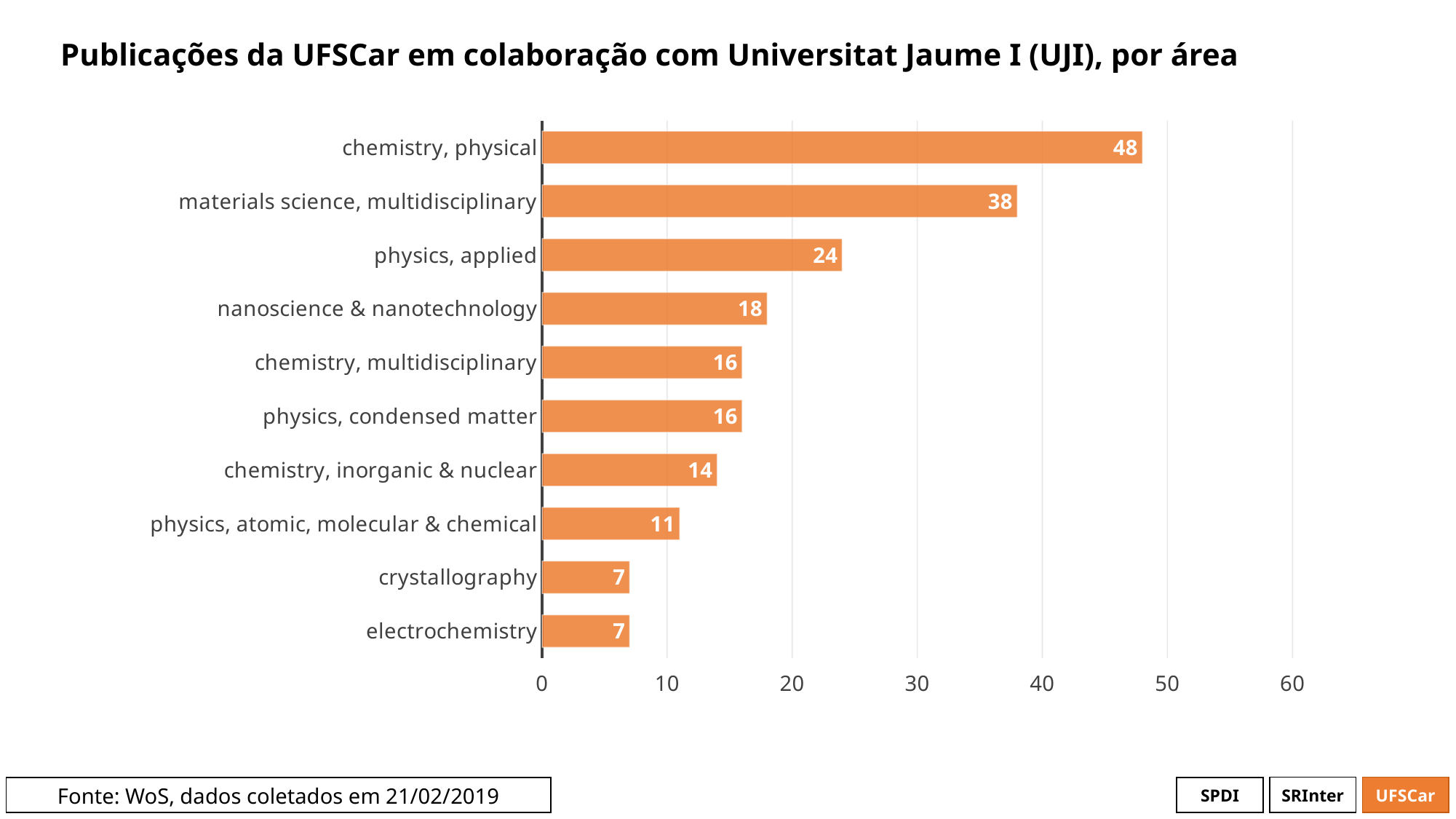
What is the title of the chart? Publicações da UFSCar em colaboração com Universitat Jaume I (UJI), por área What kind of chart is shown on the slide? bar chart How many areas are shown in the chart? 10 Is the value for materials science, multidisciplinary greater or less than 30? greater What is the value for materials science, multidisciplinary? 38 What is the value for nanoscience & nanotechnology? 18 What is the value for physics, atomic, molecular & chemical? 11 Which is larger, physics, applied or nanoscience & nanotechnology? physics, applied Which area has the highest value? chemistry, physical What is the difference between physics, applied and chemistry, inorganic & nuclear? 10 What is the value for chemistry, physical? 48 What is the difference between chemistry, physical and materials science, multidisciplinary? 10